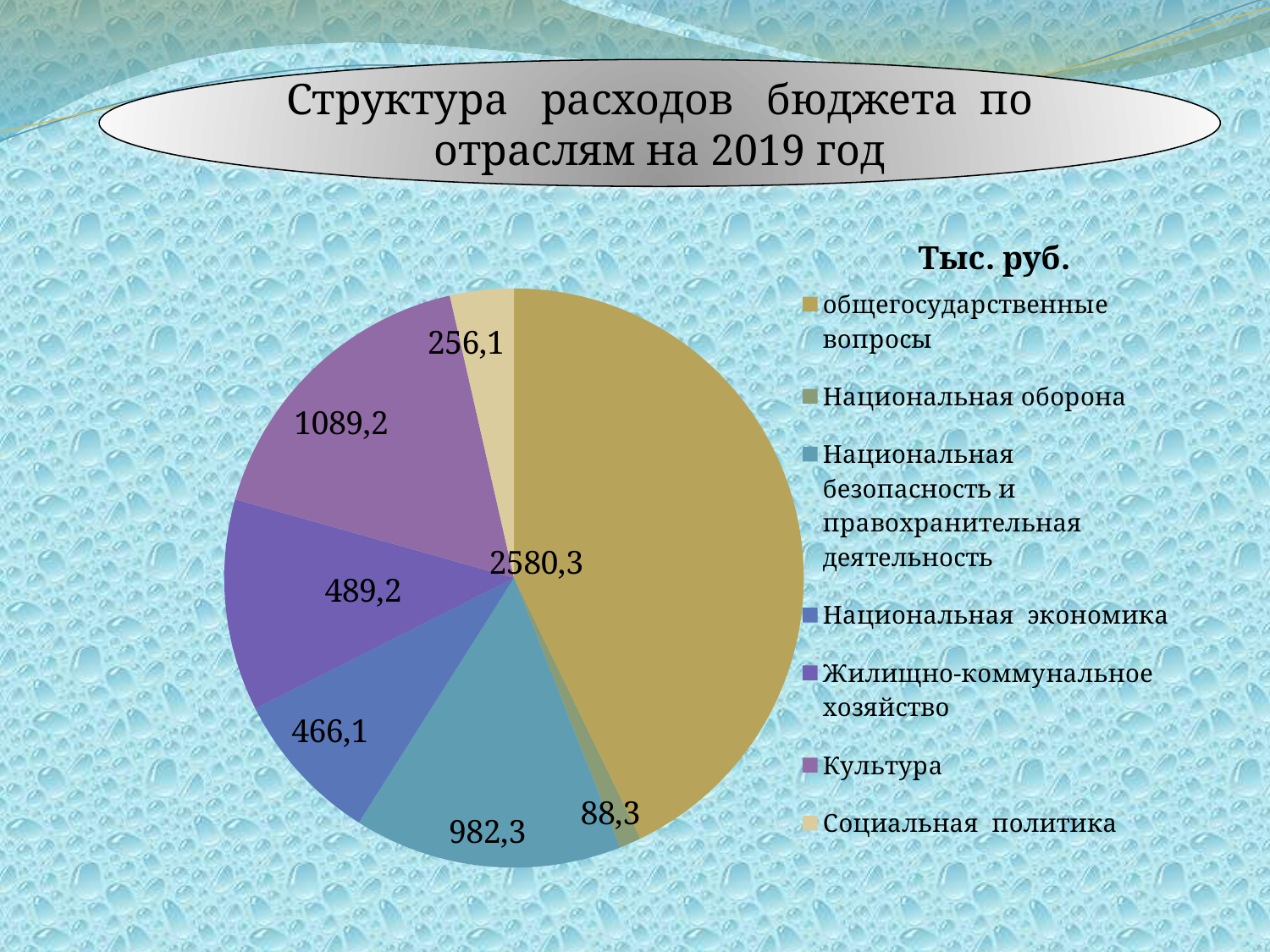
What unit is indicated above the legend? Тыс. руб. Which is larger, the value for Жилищно-коммунальное хозяйство or the value for Национальная экономика? Жилищно-коммунальное хозяйство What is the difference between the values for Жилищно-коммунальное хозяйство and Национальная экономика? 23,1 What is the difference between the values for общегосударственные вопросы and Культура? 1491,1 Which category has the largest slice of the pie? общегосударственные вопросы What is the value for Национальная безопасность и правохранительная деятельность? 982,3 What is the value for Культура? 1089,2 What is the value for Национальная оборона? 88,3 Which category has the smallest slice of the pie? Национальная оборона What is the value for Социальная политика? 256,1 What kind of chart is shown on the slide? pie chart How many categories does the legend list? 7